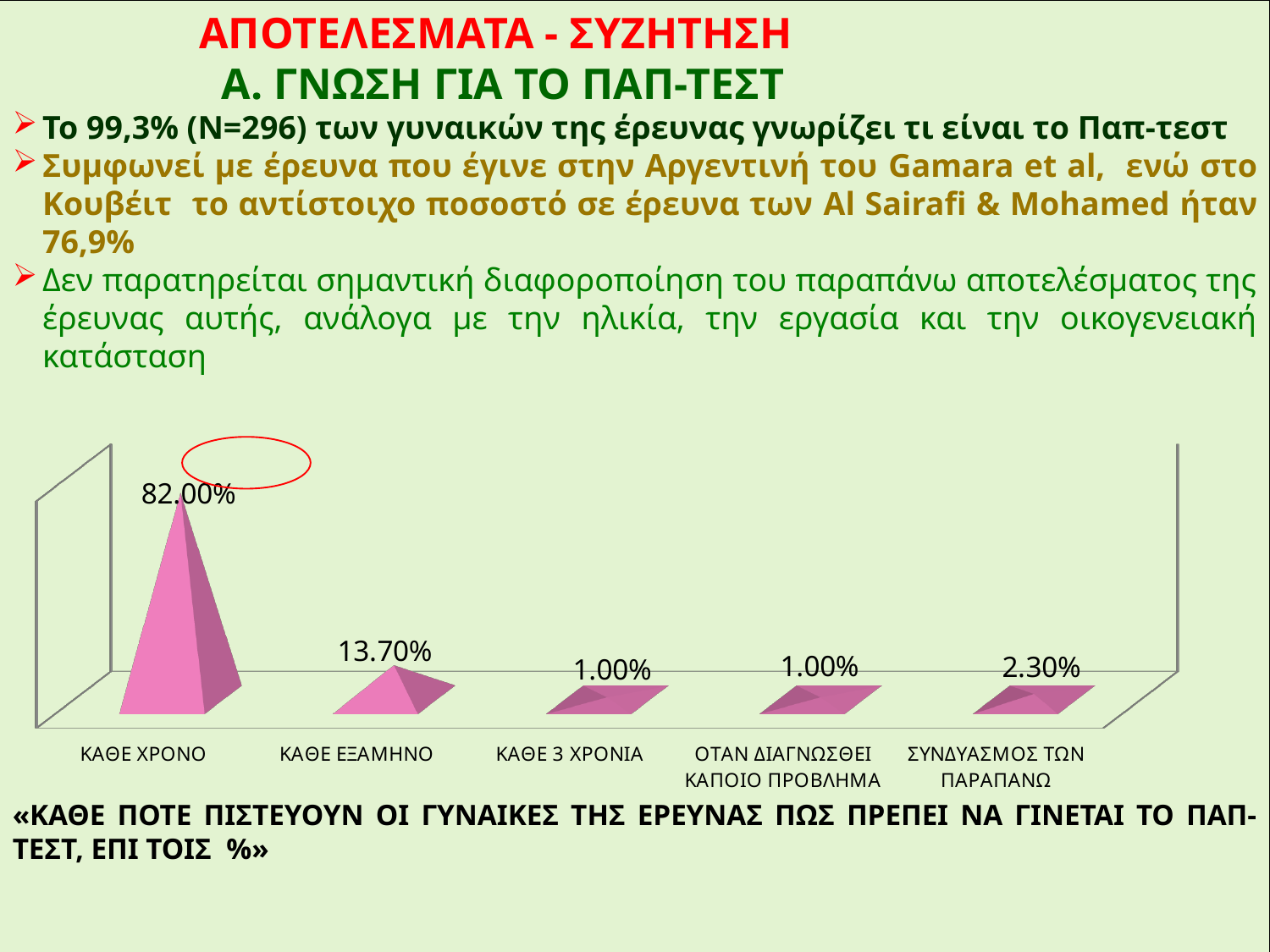
Which is larger, the value for ΚΑΘΕ ΕΞΑΜΗΝΟ or the value for ΣΥΝΔΥΑΣΜΟΣ ΤΩΝ ΠΑΡΑΠΑΝΩ? ΚΑΘΕ ΕΞΑΜΗΝΟ What kind of chart is shown on the slide? Bar chart What value is shown for ΚΑΘΕ ΕΞΑΜΗΝΟ? 13.70% What is the title printed below the chart? «ΚΑΘΕ ΠΟΤΕ ΠΙΣΤΕΥΟΥΝ ΟΙ ΓΥΝΑΙΚΕΣ ΤΗΣ ΕΡΕΥΝΑΣ ΠΩΣ ΠΡΕΠΕΙ ΝΑ ΓΙΝΕΤΑΙ ΤΟ ΠΑΠ-ΤΕΣΤ, ΕΠΙ ΤΟΙΣ %» What is the difference between the values for ΣΥΝΔΥΑΣΜΟΣ ΤΩΝ ΠΑΡΑΠΑΝΩ and ΚΑΘΕ 3 ΧΡΟΝΙΑ? 1.30% What value is shown for ΟΤΑΝ ΔΙΑΓΝΩΣΘΕΙ ΚΑΠΟΙΟ ΠΡΟΒΛΗΜΑ? 1.00% How many categories are shown in the chart? 5 What is the difference between the values for ΚΑΘΕ ΧΡΟΝΟ and ΚΑΘΕ ΕΞΑΜΗΝΟ? 68.30% Which category has the highest value? ΚΑΘΕ ΧΡΟΝΟ What value is shown for ΚΑΘΕ ΧΡΟΝΟ? 82.00% What value is shown for ΣΥΝΔΥΑΣΜΟΣ ΤΩΝ ΠΑΡΑΠΑΝΩ? 2.30% Which is larger, the value for ΣΥΝΔΥΑΣΜΟΣ ΤΩΝ ΠΑΡΑΠΑΝΩ or the value for ΚΑΘΕ 3 ΧΡΟΝΙΑ? ΣΥΝΔΥΑΣΜΟΣ ΤΩΝ ΠΑΡΑΠΑΝΩ